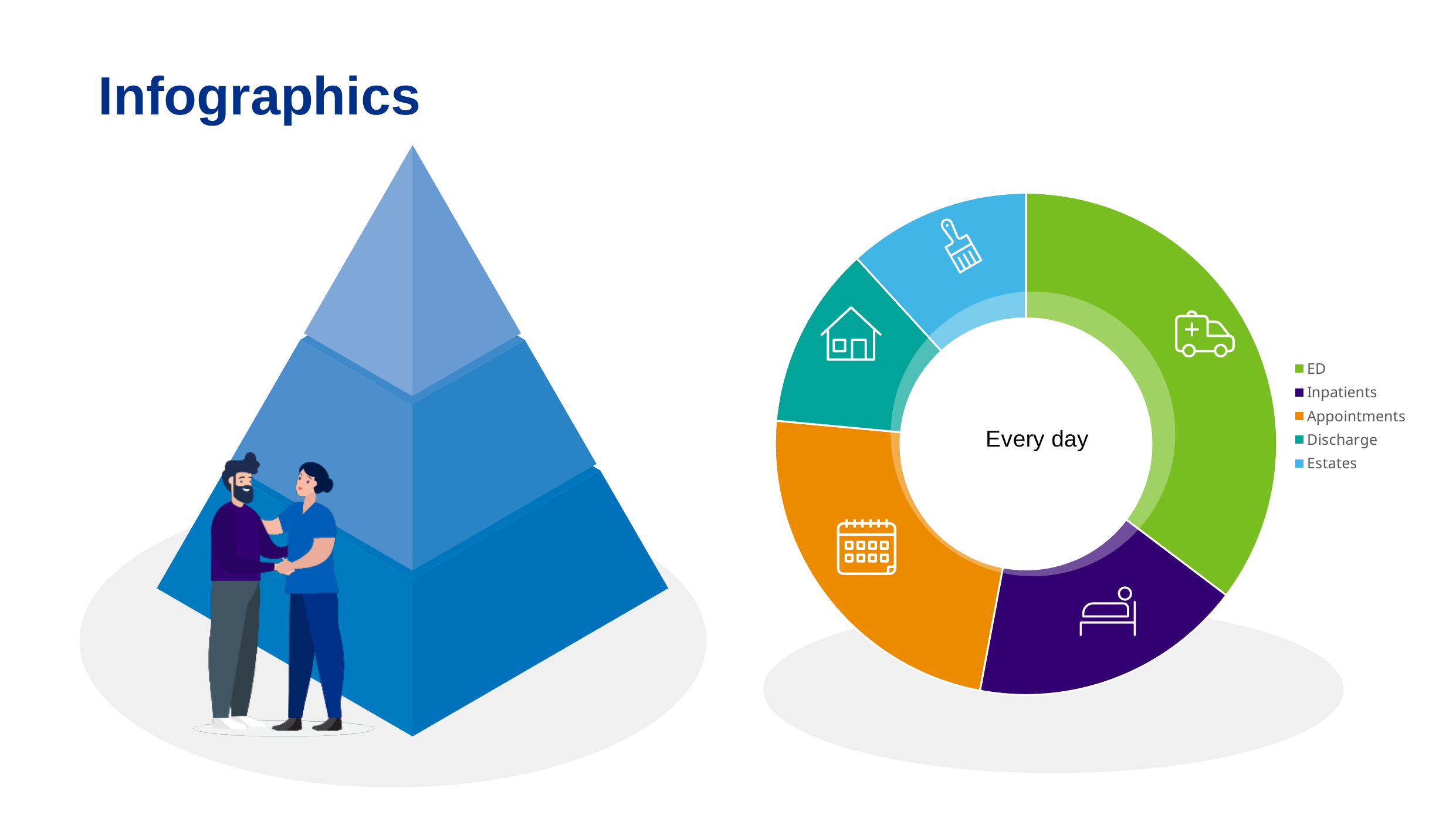
Which colour represents Appointments in the doughnut chart? Orange In the doughnut chart, which slice is larger, ED or Inpatients? ED What text is shown in the centre of the doughnut chart? Every day Which category has the largest slice in the doughnut chart? ED How many categories does the legend of the doughnut chart list? 5 In the doughnut chart, which slice is larger, Inpatients or Estates? Inpatients What kind of chart is shown on the right of the slide? Doughnut chart In the doughnut chart, which slice is larger, Appointments or Discharge? Appointments